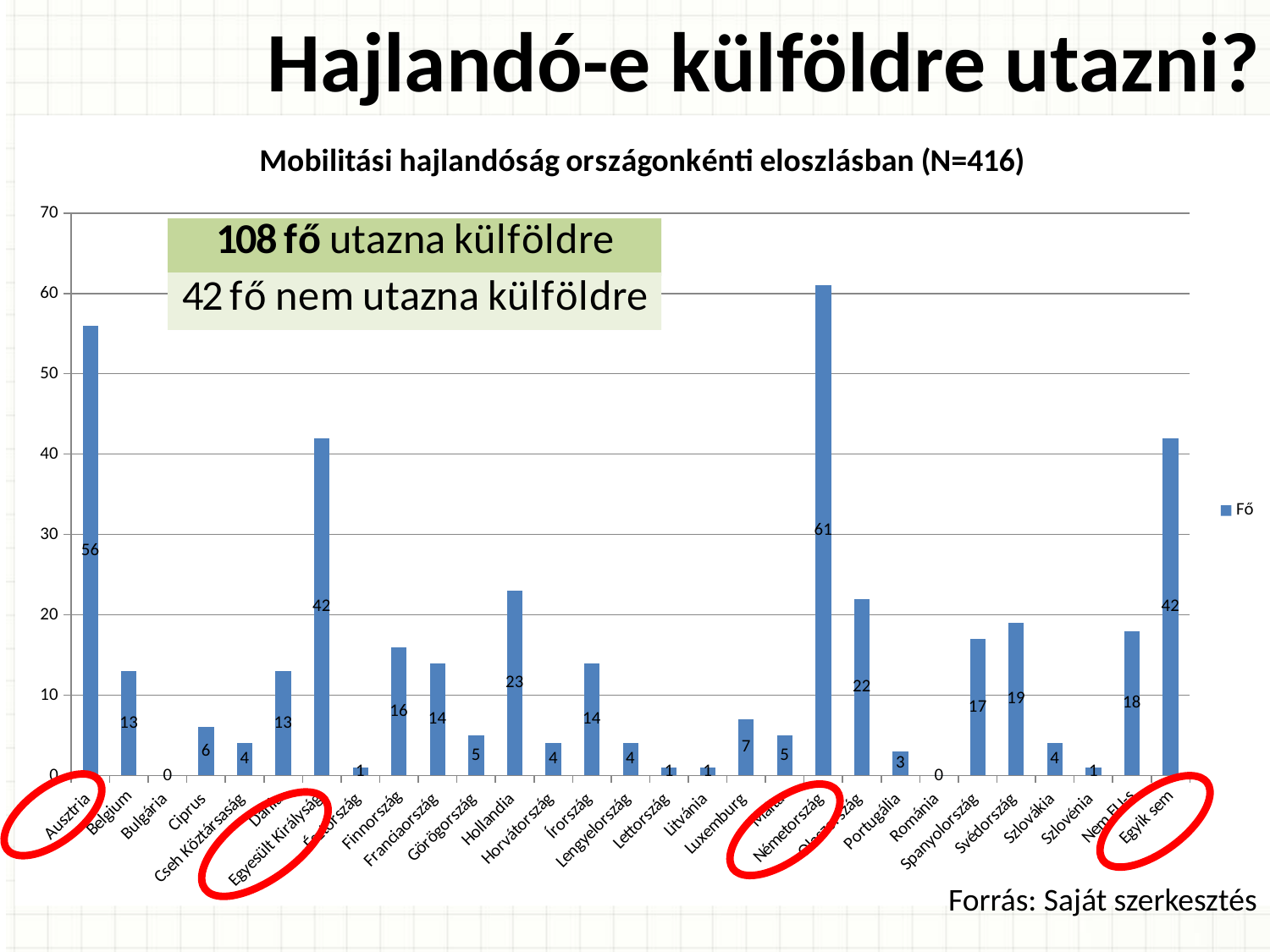
How many series does the legend list? 1 What kind of chart is shown? bar chart What is the value for Ausztria? 56 What is the value for Svédország? 19 Which is larger, the value for Finnország or Franciaország? Finnország What is the value for Németország? 61 What is the legend entry of the chart? Fő Is the value for Olaszország greater or less than 20? greater What is the difference between the values for Németország and Ausztria? 5 What is the value for Hollandia? 23 Which country has the highest value? Németország Is the value for Portugália greater or less than 10? less